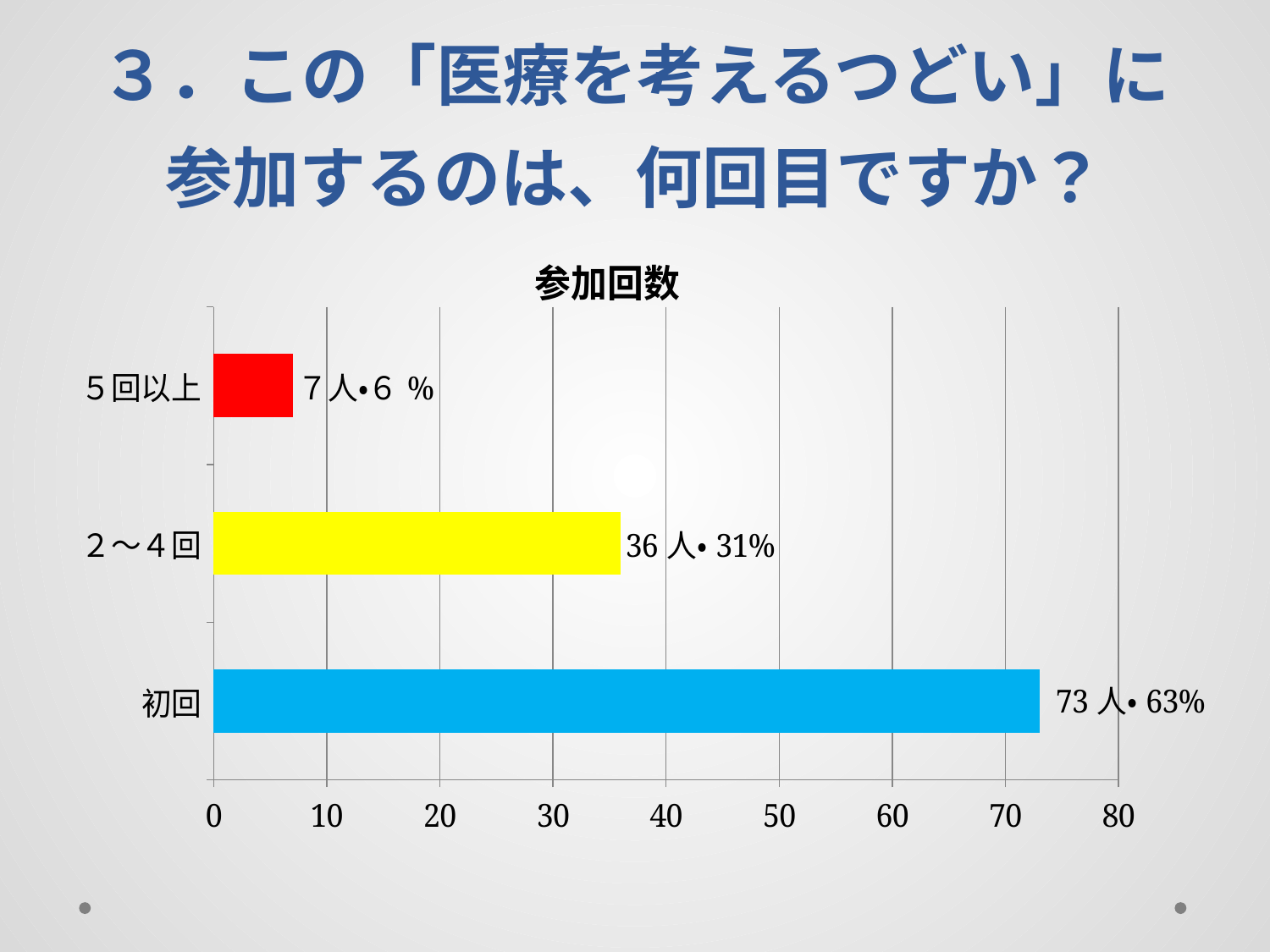
What is the difference in number of people between 初回 and ２～４回? 37 人 Which is larger, the value for ２～４回 or the value for ５回以上? ２～４回 What is the value for ５回以上? 7 人・6％ What is the difference in number of people between ２～４回 and ５回以上? 29 人 What is the value for 初回? 73 人・63% Which category has the highest value? 初回 What kind of chart is shown on the slide? bar chart What is the value for ２～４回? 36 人・31% Is the value for 初回 greater or less than 70? greater Which category has the lowest value? ５回以上 How many categories are shown in the chart? 3 What is the title of the chart? 参加回数